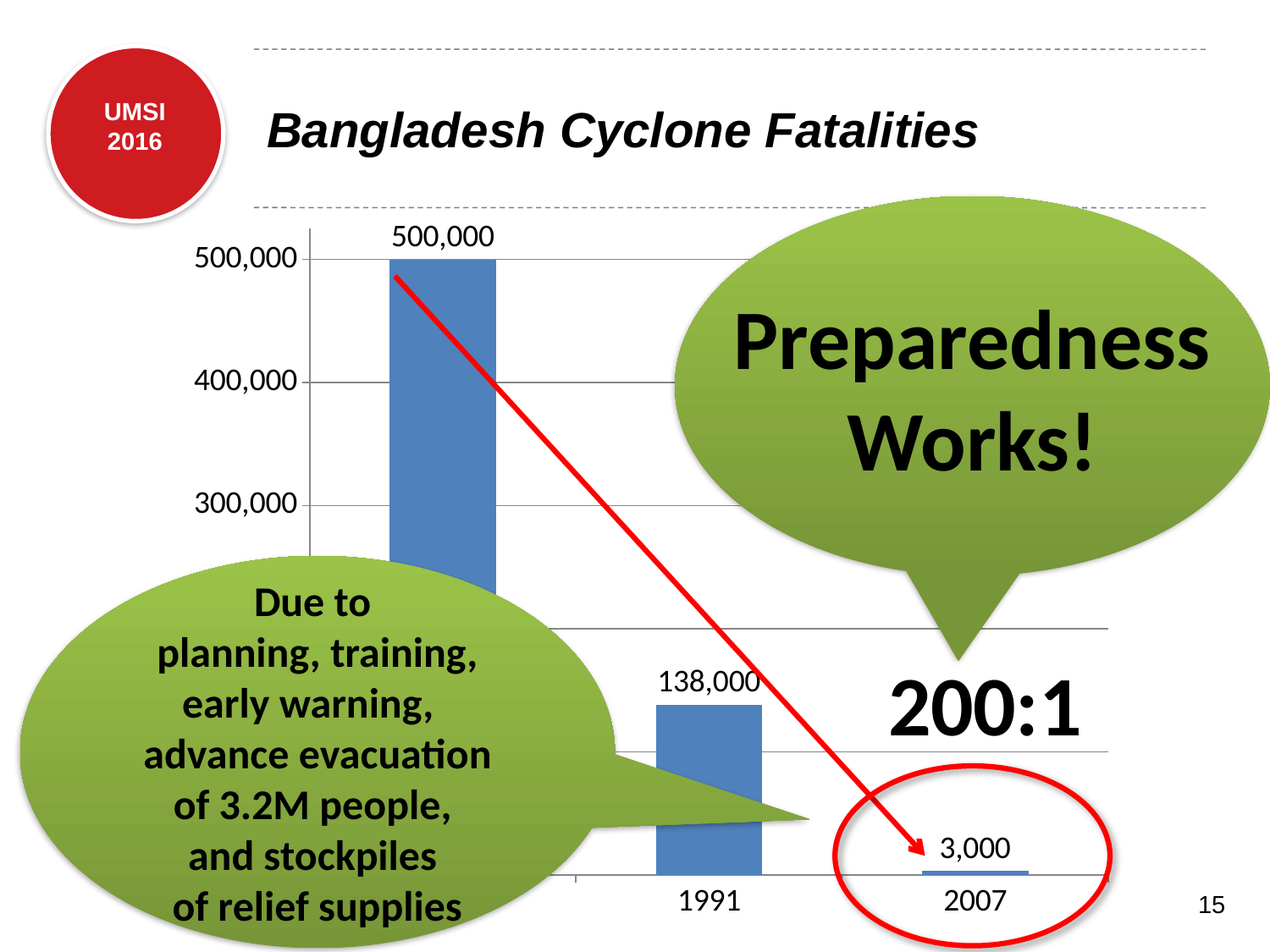
Do the values rise or fall from left to right along the x axis? fall What is the difference between the values for 1991 and 2007? 135,000 What is the value for 2007 in the Bangladesh Cyclone Fatalities chart? 3,000 What is the title of the chart? Bangladesh Cyclone Fatalities Which is larger, the value for 1991 or the value for 2007? 1991 Which year has the lowest value in the Bangladesh Cyclone Fatalities chart? 2007 What colour are the bars in the chart? blue What is the value for 1991 in the Bangladesh Cyclone Fatalities chart? 138,000 How many bars are plotted in the Bangladesh Cyclone Fatalities chart? 3 What type of chart is shown on the slide? bar chart Is the value for 1991 greater or less than 200,000? less What is the highest value shown in the Bangladesh Cyclone Fatalities chart? 500,000